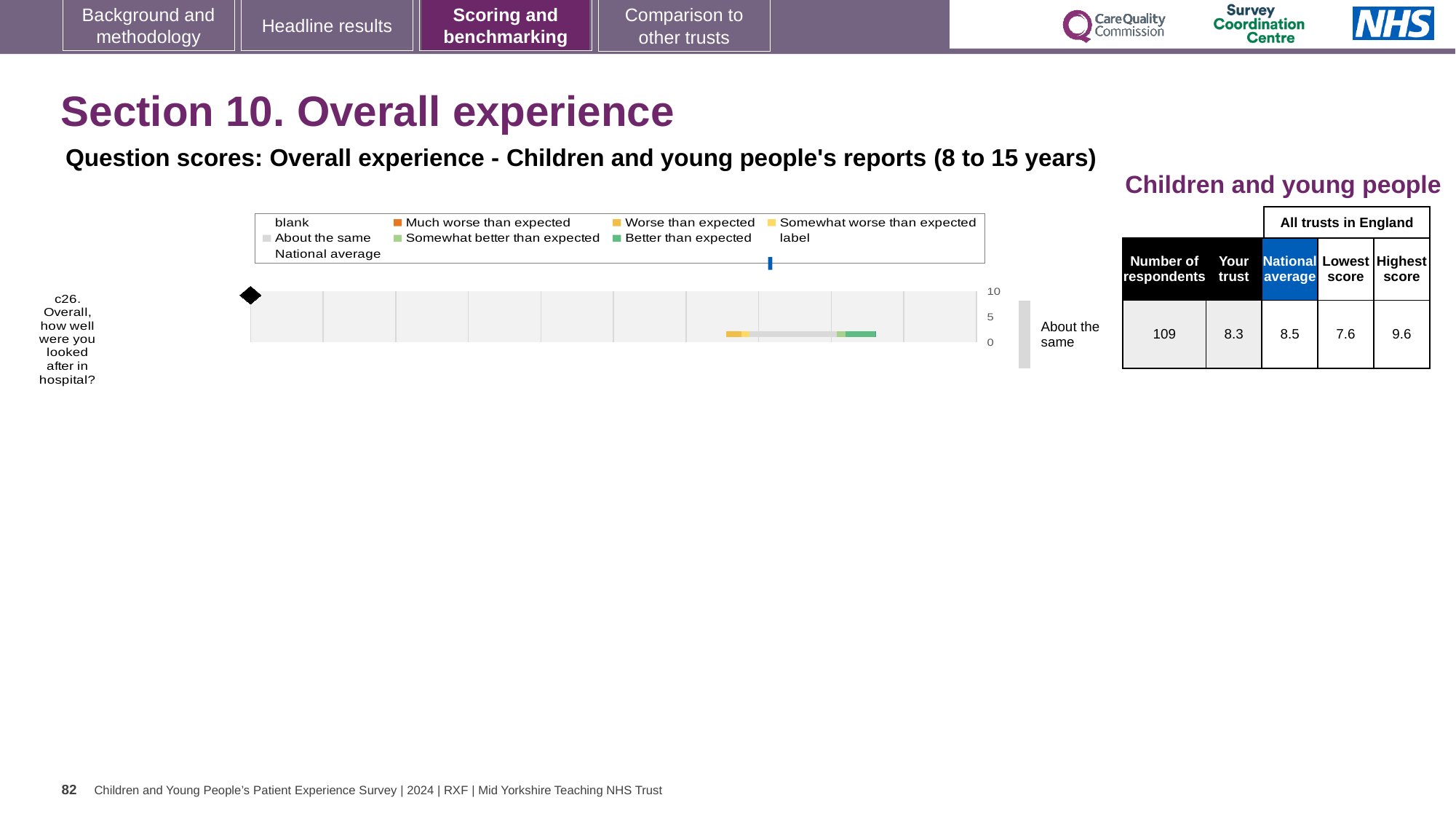
How many respondents answered question c26? 109 What is the highest score among all trusts in England for question c26? 9.6 What is the lowest score among all trusts in England for question c26? 7.6 What benchmark category is shown next to the bar for question c26? About the same What is the difference between the national average (8.5) and the 'Your trust' score (8.3) for question c26? 0.2 What is the difference between the highest score (9.6) and the lowest score (7.6) for question c26? 2.0 What kind of chart is used to show the question score for c26? bar chart How many survey questions are plotted in the chart? 1 What is the label of the question plotted in the chart? c26. Overall, how well were you looked after in hospital? What is the 'Your trust' score for question c26 shown in the table beside the chart? 8.3 Which is larger for question c26: the 'Your trust' score or the national average? National average What is the national average score for question c26 shown in the table beside the chart? 8.5